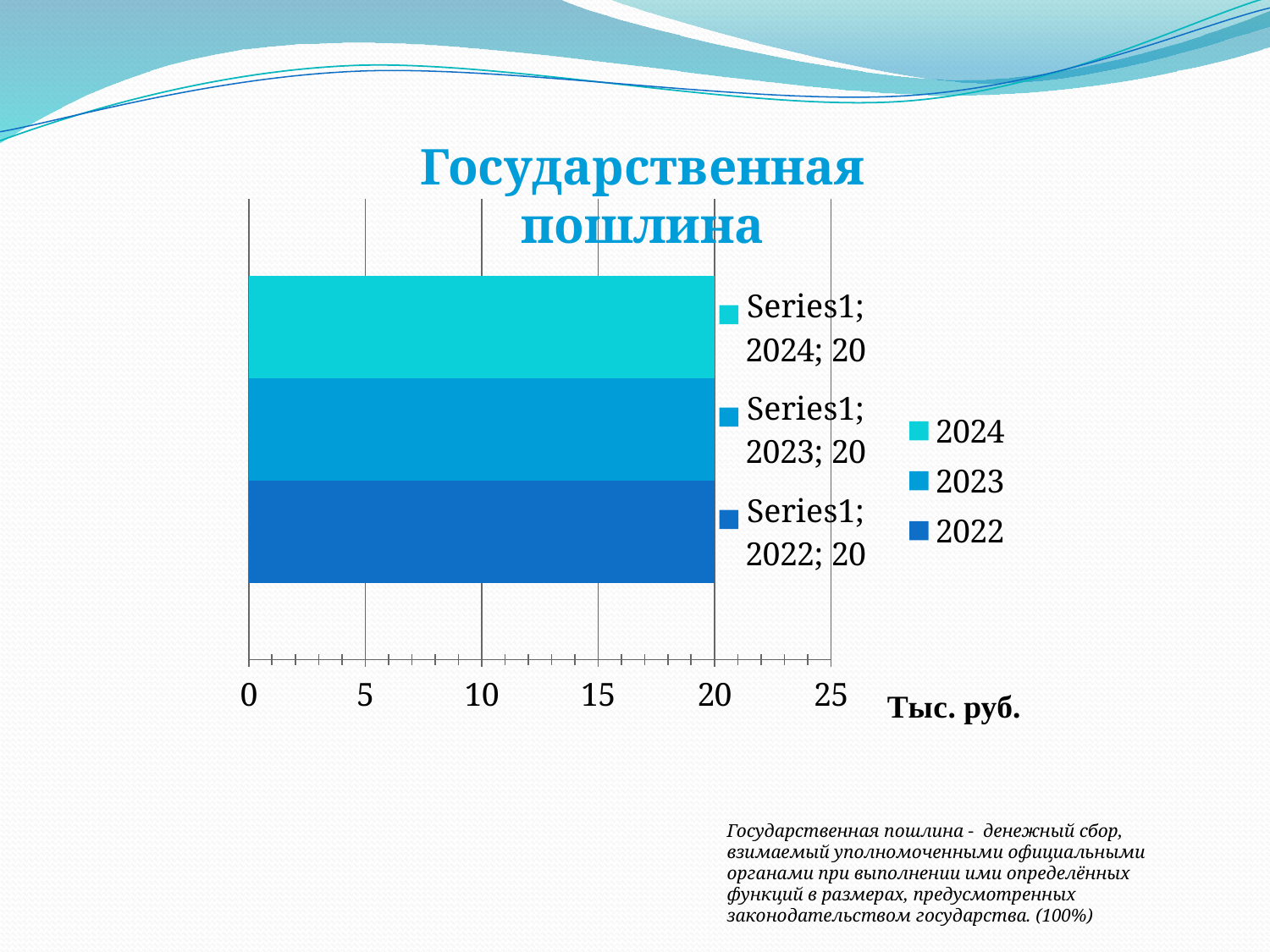
What kind of chart is shown on the slide? bar chart What is the title of the chart? Государственная пошлина What unit is shown next to the horizontal axis? Тыс. руб. How many bars are plotted in the chart? 3 What is the value for 2022 in the chart? 20 What is the difference between the values for 2024 and 2022? 0 Is the value for 2023 greater or less than 15? greater How many entries does the legend list? 3 What is the value for 2023 in the chart? 20 What is the value for 2024 in the chart? 20 Is the value for 2022 greater or less than 25? less Do the values change between 2022 and 2024? No, they stay the same